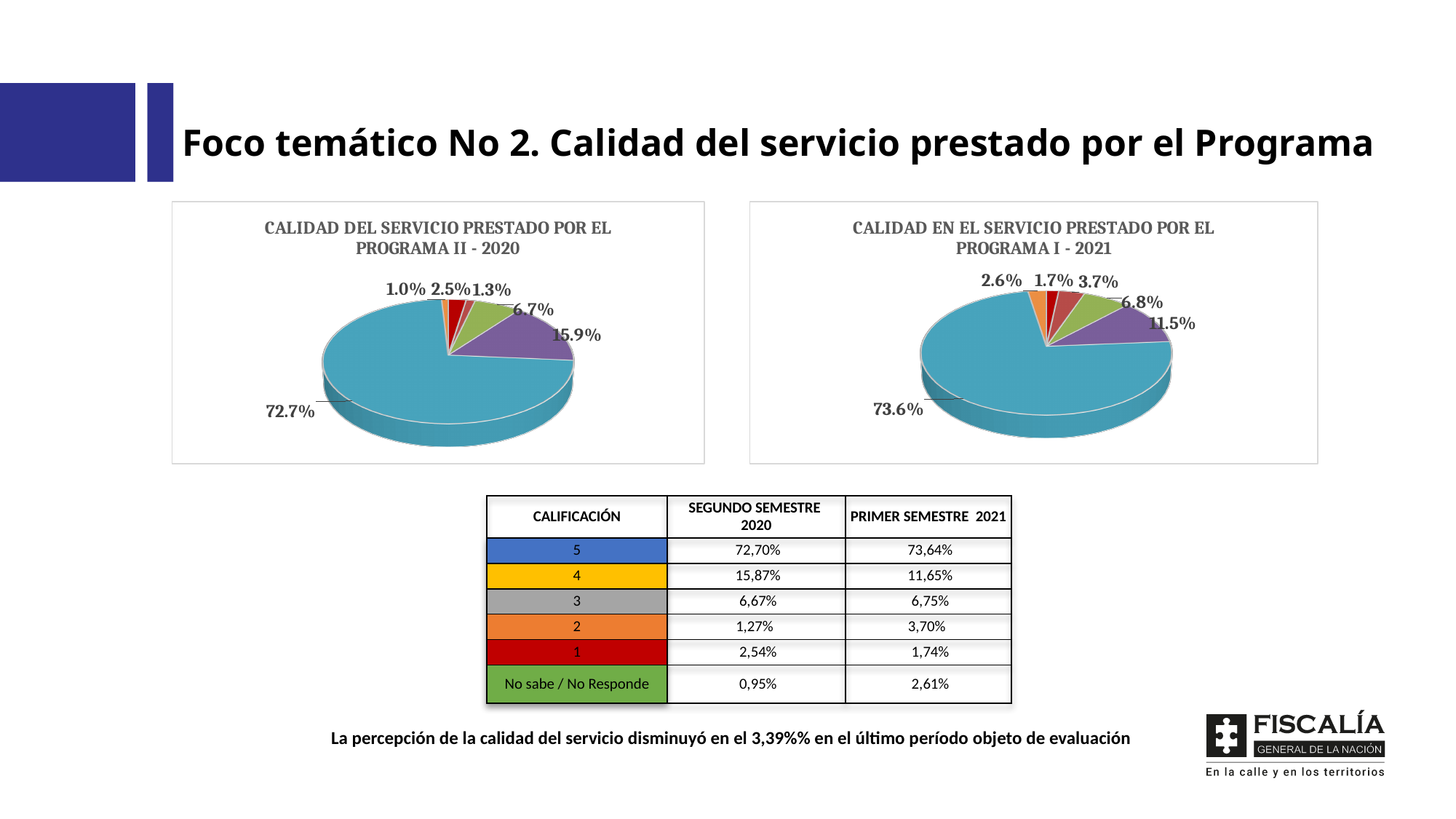
What is the title of the pie chart on the right of the slide? CALIDAD EN EL SERVICIO PRESTADO POR EL PROGRAMA I - 2021 In the right pie chart (PROGRAMA I - 2021), what is the share of the second-largest (purple) slice? 11.5% What kind of chart is the chart titled "CALIDAD DEL SERVICIO PRESTADO POR EL PROGRAMA II - 2020"? Pie chart What is the difference between the second-largest slice of the left pie chart (15.9%) and the second-largest slice of the right pie chart (11.5%)? 4.4% What is the title of the pie chart on the left of the slide? CALIDAD DEL SERVICIO PRESTADO POR EL PROGRAMA II - 2020 In the left pie chart (PROGRAMA II - 2020), what is the share of the smallest slice? 1.0% In the right pie chart (PROGRAMA I - 2021), what is the share of the smallest slice? 1.7% In the right pie chart (PROGRAMA I - 2021), what is the share of the largest slice? 73.6% How many slices does the pie chart on the left (PROGRAMA II - 2020) have? 6 How many slices does the pie chart on the right (PROGRAMA I - 2021) have? 6 Which chart has the larger biggest slice: the left pie chart (PROGRAMA II - 2020) or the right pie chart (PROGRAMA I - 2021)? The right pie chart (PROGRAMA I - 2021), 73.6% In the left pie chart (PROGRAMA II - 2020), what is the share of the largest slice? 72.7%